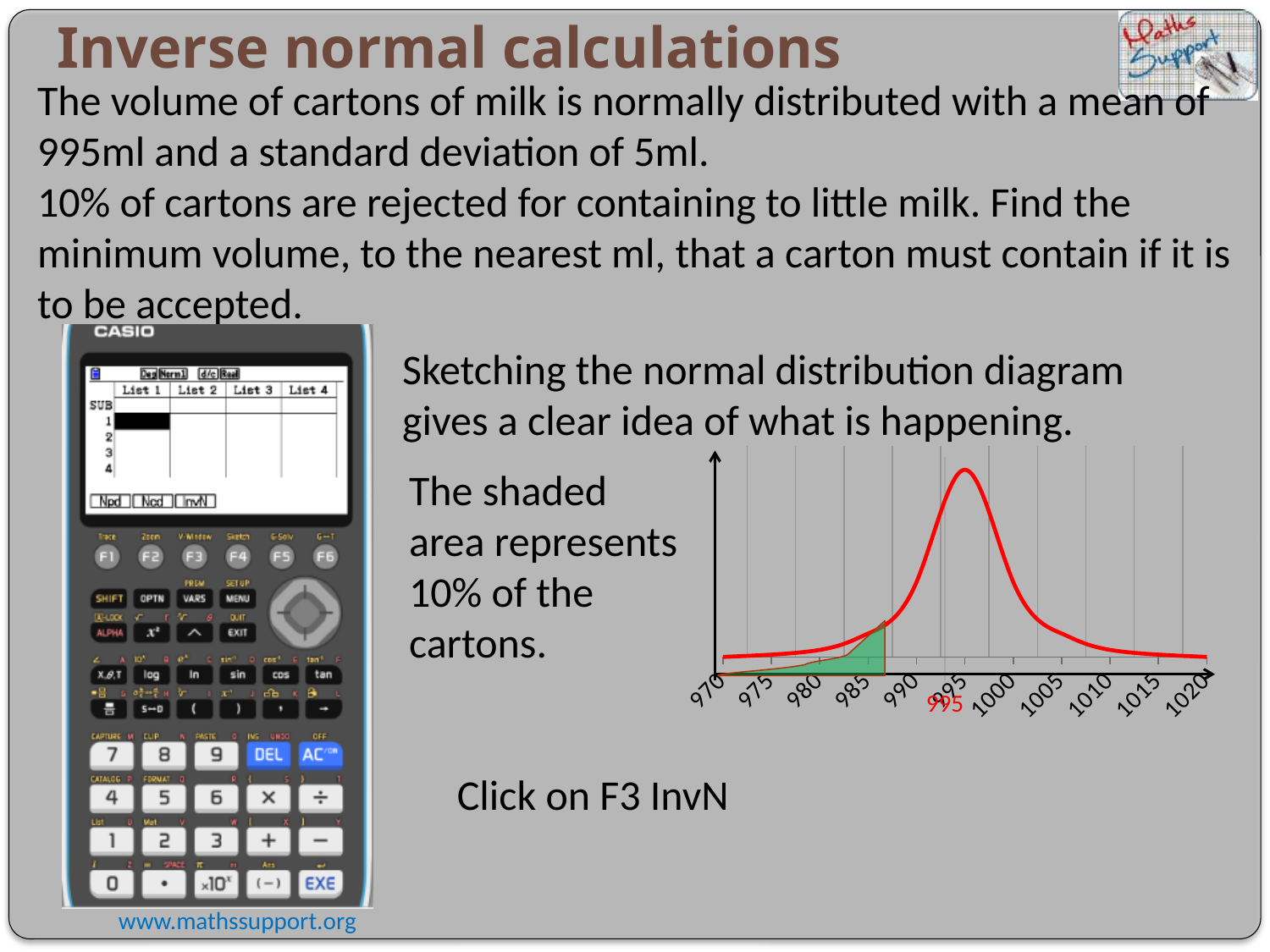
Is the curve higher at 1005 or at 1015? 1005 How many labelled tick values are shown on the x axis of the chart? 11 Is the curve higher at 985 or at 995? 995 What is the smallest value labelled on the x axis of the chart? 970 What kind of chart is shown on the slide? line chart What is the largest value labelled on the x axis of the chart? 1020 Which x-axis label on the chart is written in red? 995 Is the shaded region to the left or to the right of the peak of the curve? left What colour is the shaded area under the curve? green Does the red curve rise or fall as x increases from 995 to 1020? fall Does the red curve rise or fall as x increases from 970 to 995? rise At which x-axis value does the red curve reach its highest point? 995